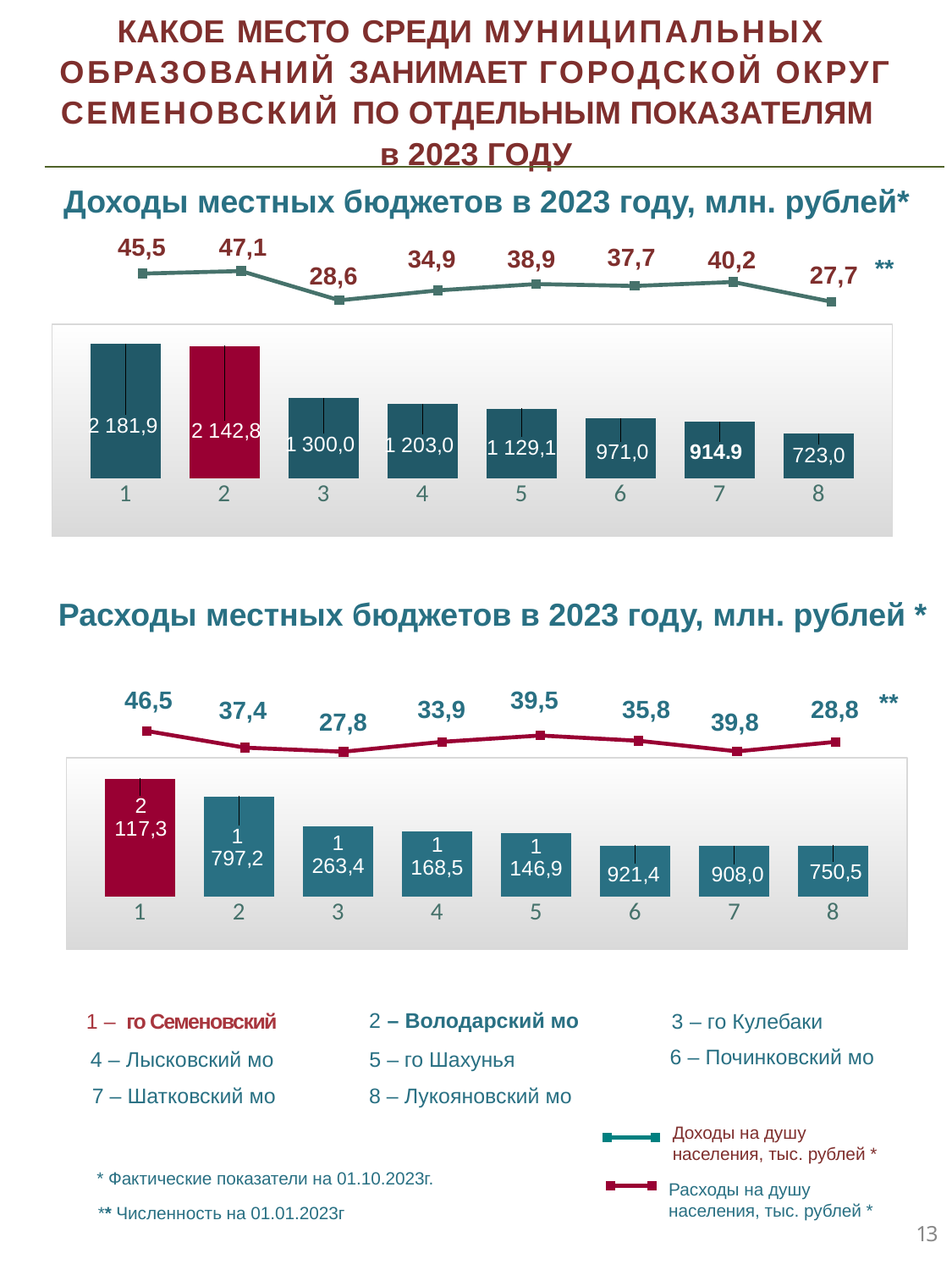
In the chart 'Расходы местных бюджетов в 2023 году, млн. рублей *', do the bar values rise or fall from category 1 to category 8? Fall According to the key on the slide, which municipality is category 1? го Семеновский In the chart 'Доходы местных бюджетов в 2023 году, млн. рублей*', what is the difference between the bar values for categories 1 and 2? 39,1 In the chart 'Доходы местных бюджетов в 2023 году, млн. рублей*', which category has the highest per-capita income value on the line? 2 In the chart 'Расходы местных бюджетов в 2023 году, млн. рублей *', which is larger: the bar value for category 6 or for category 7? Category 6 In the chart 'Доходы местных бюджетов в 2023 году, млн. рублей*', what is the bar value for category 1? 2 181,9 In the chart 'Расходы местных бюджетов в 2023 году, млн. рублей *', which category has the lowest bar value? 8 What type of chart is used for the bottom chart 'Расходы местных бюджетов в 2023 году, млн. рублей *'? Bar chart with a line In the chart 'Расходы местных бюджетов в 2023 году, млн. рублей *', what is the bar value for category 1? 2 117,3 In the chart 'Расходы местных бюджетов в 2023 году, млн. рублей *', what is the per-capita expenditure value on the line for category 3? 27,8 In the chart 'Доходы местных бюджетов в 2023 году, млн. рублей*', what is the bar value for category 8? 723,0 In the chart 'Доходы местных бюджетов в 2023 году, млн. рублей*', how many bars are plotted? 8